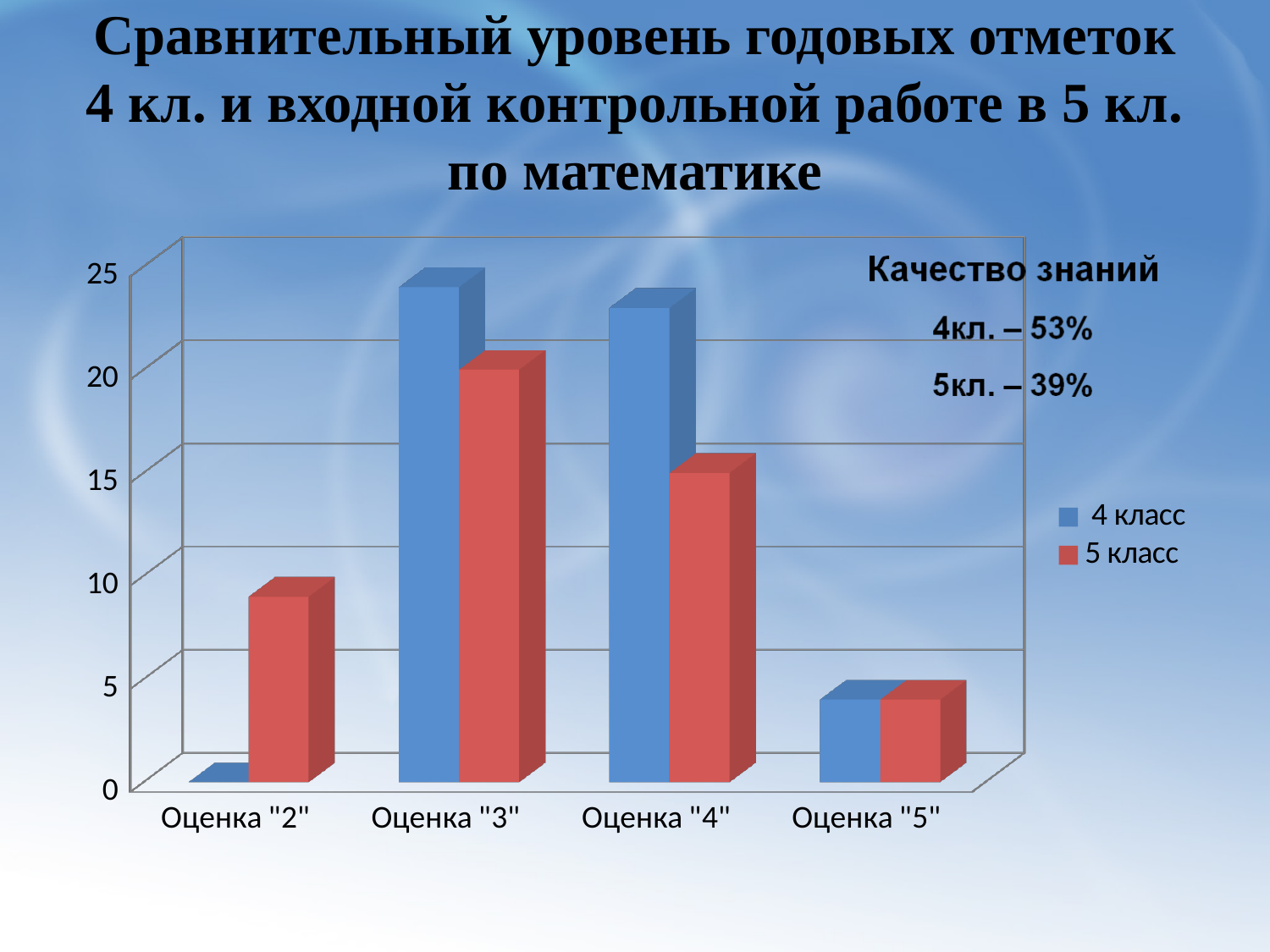
Is the 4 класс value for Оценка "4" greater or less than 20? greater How many categories are shown on the x axis? 4 For which category is the 5 класс value highest? Оценка "3" For Оценка "3", which series has the larger value, 4 класс or 5 класс? 4 класс For Оценка "2", which series has the larger value, 4 класс or 5 класс? 5 класс How many series does the legend list? 2 For which category is the 5 класс value lowest? Оценка "5" Is the 4 класс value for Оценка "3" greater or less than 20? greater What kind of chart is shown on the slide? bar chart For which category is the 4 класс value lowest? Оценка "2" Is the 5 класс value for Оценка "2" greater or less than 10? less According to the text on the slide, what is the Качество знаний for 5 кл.? 39%